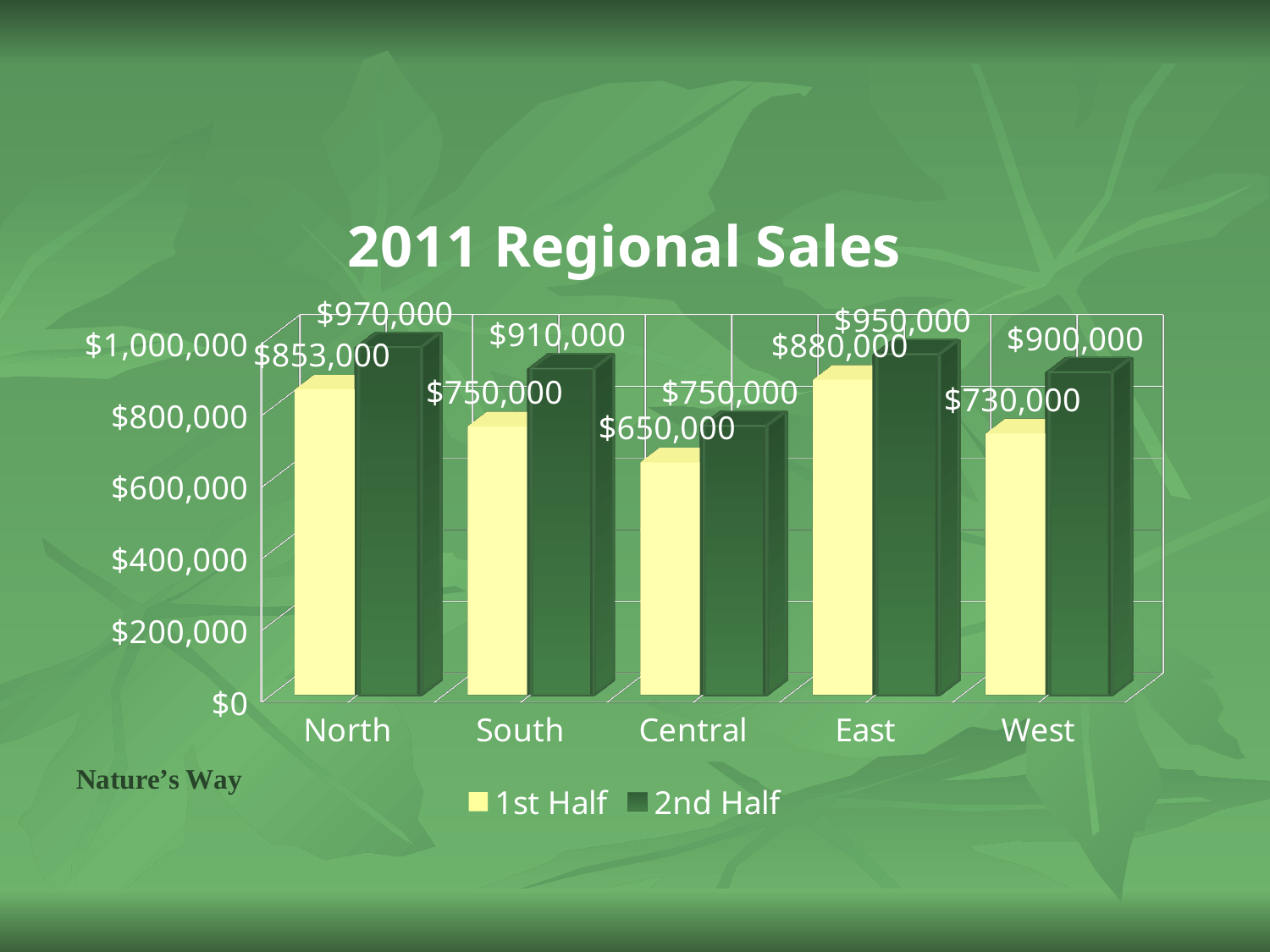
Which is larger, the 1st Half value for East or the 1st Half value for North? East Which region has the highest 2nd Half value? North Which region has the lowest 1st Half value? Central How many series does the legend list? 2 How many regions are shown on the x axis? 5 What is the 1st Half value for Central? $650,000 What kind of chart is shown? bar chart What is the difference between the 2nd Half and 1st Half values for South? $160,000 Is the 2nd Half value for Central greater or less than $800,000? less What is the title of the chart? 2011 Regional Sales What is the 1st Half value for North? $853,000 What is the 2nd Half value for West? $900,000